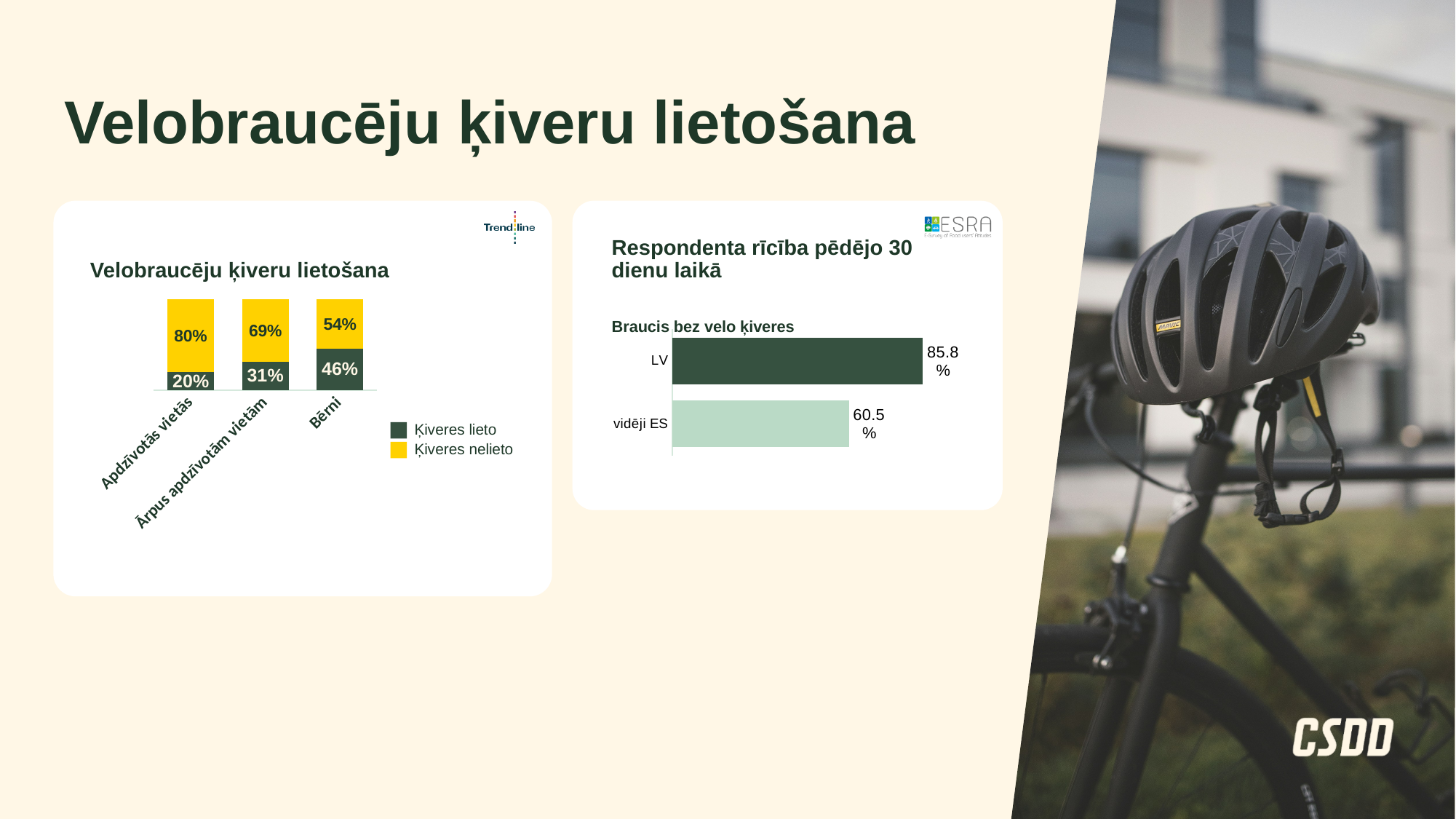
In the chart titled "Velobraucēju ķiveru lietošana", which category has the lowest "Ķiveres nelieto" share? Bērni In the chart titled "Velobraucēju ķiveru lietošana", which category has the highest "Ķiveres lieto" share? Bērni In the chart titled "Velobraucēju ķiveru lietošana", what is the "Ķiveres nelieto" value for "Ārpus apdzīvotām vietām"? 69% In the chart titled "Velobraucēju ķiveru lietošana", what percentage of the "Apdzīvotās vietās" bar is "Ķiveres lieto"? 20% In the chart titled "Velobraucēju ķiveru lietošana", how many categories are shown on the x axis? 3 In the chart titled "Respondenta rīcība pēdējo 30 dienu laikā", what is the value for LV? 85.8% In the chart titled "Velobraucēju ķiveru lietošana", how many series does the legend list? 2 In the chart titled "Velobraucēju ķiveru lietošana", what is the difference between the "Ķiveres nelieto" values for "Apdzīvotās vietās" and "Bērni"? 26% In the chart titled "Respondenta rīcība pēdējo 30 dienu laikā", what is the difference between the LV and vidēji ES values? 25.3% In the chart titled "Velobraucēju ķiveru lietošana", what is the "Ķiveres lieto" value for "Bērni"? 46% In the chart titled "Velobraucēju ķiveru lietošana", which colour represents "Ķiveres nelieto"? Yellow What kind of chart is the one titled "Respondenta rīcība pēdējo 30 dienu laikā"? Bar chart